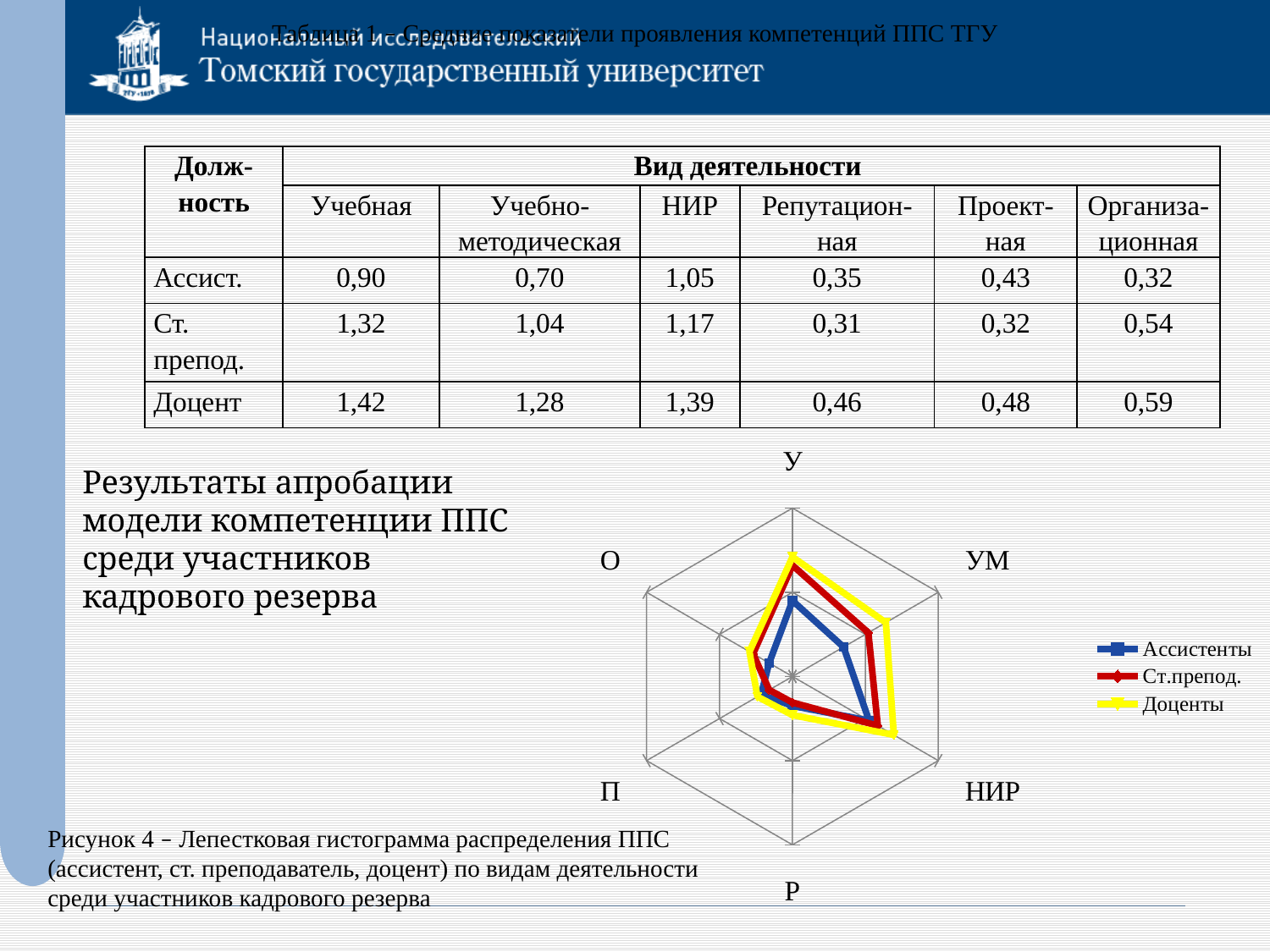
On the УМ axis of the radar chart, which series is larger: Доценты or Ассистенты? Доценты According to the table on the slide, what is the Учебная value for Доцент? 1,42 On the О axis of the radar chart, which series is larger: Ассистенты or Доценты? Доценты What kind of chart is shown on the slide? Radar chart Which series has the largest value on the У axis of the radar chart? Доценты According to the table on the slide, what is the difference between the Учебная values for Доцент and Ассист.? 0,52 How many series does the legend of the radar chart list? 3 Which series has the smallest value on the УМ axis of the radar chart? Ассистенты How many axes (categories) does the radar chart have? 6 According to the table on the slide, what is the НИР value for Ассист.? 1,05 What colour is the Доценты series drawn in on the radar chart? Yellow What are the three series named in the legend of the radar chart? Ассистенты, Ст.препод., Доценты